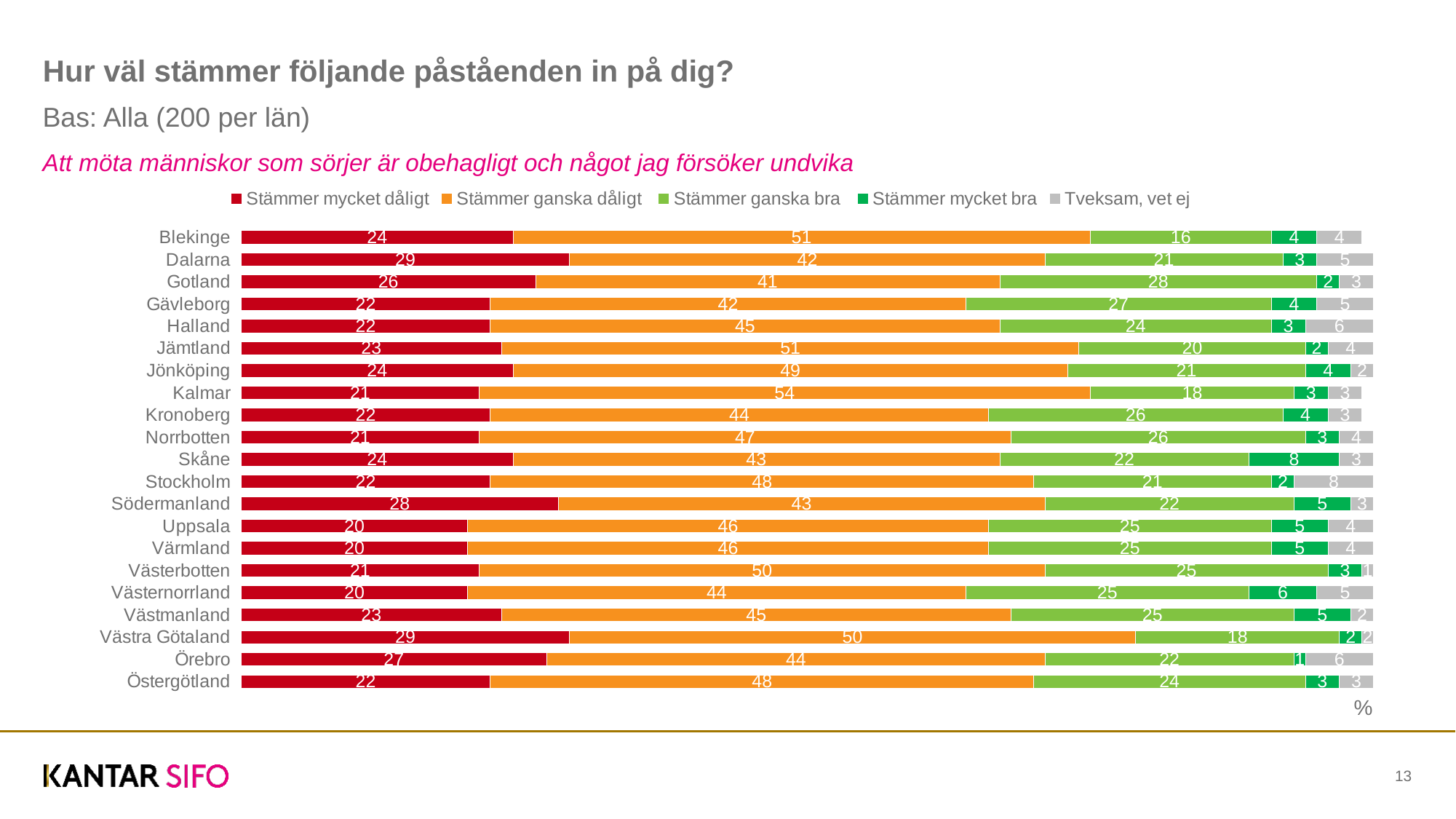
What is the value for 'Stämmer mycket bra' for Skåne? 8 What is the value for 'Tveksam, vet ej' for Stockholm? 8 Which is larger: the 'Stämmer mycket dåligt' value for Dalarna or for Uppsala? Dalarna What is the difference between the 'Stämmer ganska dåligt' values for Kalmar and Gotland? 13 What is the first legend entry (the dark red series)? Stämmer mycket dåligt Which county has the lowest value for 'Stämmer ganska bra'? Blekinge What is the total of the stacked bar for Skåne? 100 Which county has the highest value for 'Stämmer ganska dåligt'? Kalmar How many series does the legend list? 5 How many counties (categories) are shown in the chart? 21 What is the value for 'Stämmer ganska dåligt' for Kalmar? 54 What kind of chart is shown on the slide? Stacked bar chart